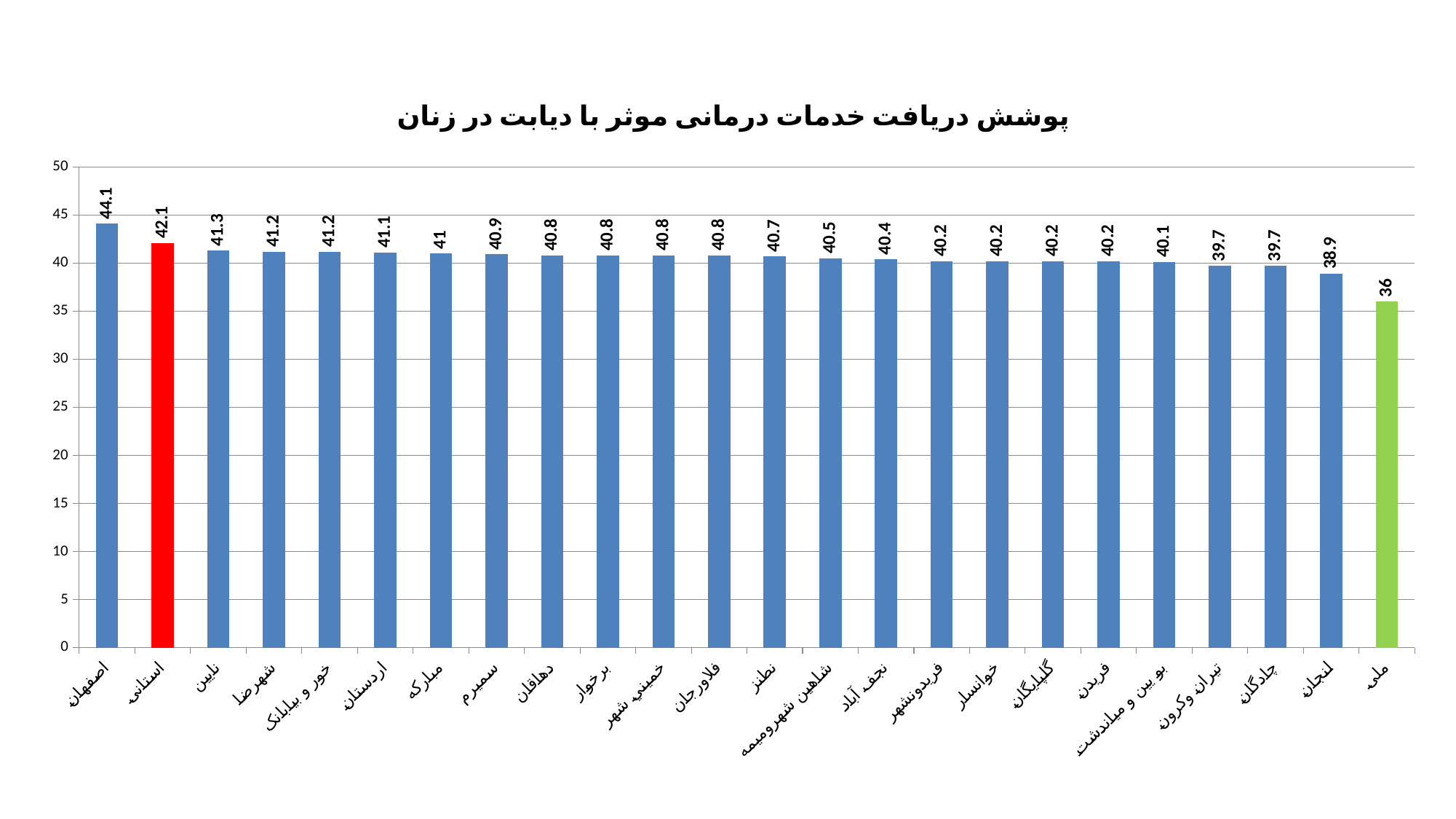
What kind of chart is shown on the slide? bar chart Which category has the highest value? اصفهان What colour is the bar for ملی? green How many bars are shown in the chart? 24 What is the difference between the values for اصفهان and ملی? 8.1 Which category has the lowest value? ملی What is the value for اصفهان? 44.1 What is the value for لنجان? 38.9 What is the value for ملی? 36 What is the value for استانی? 42.1 What is the value for نطنز? 40.7 Which is larger, the value for استانی or the value for نایین? استانی